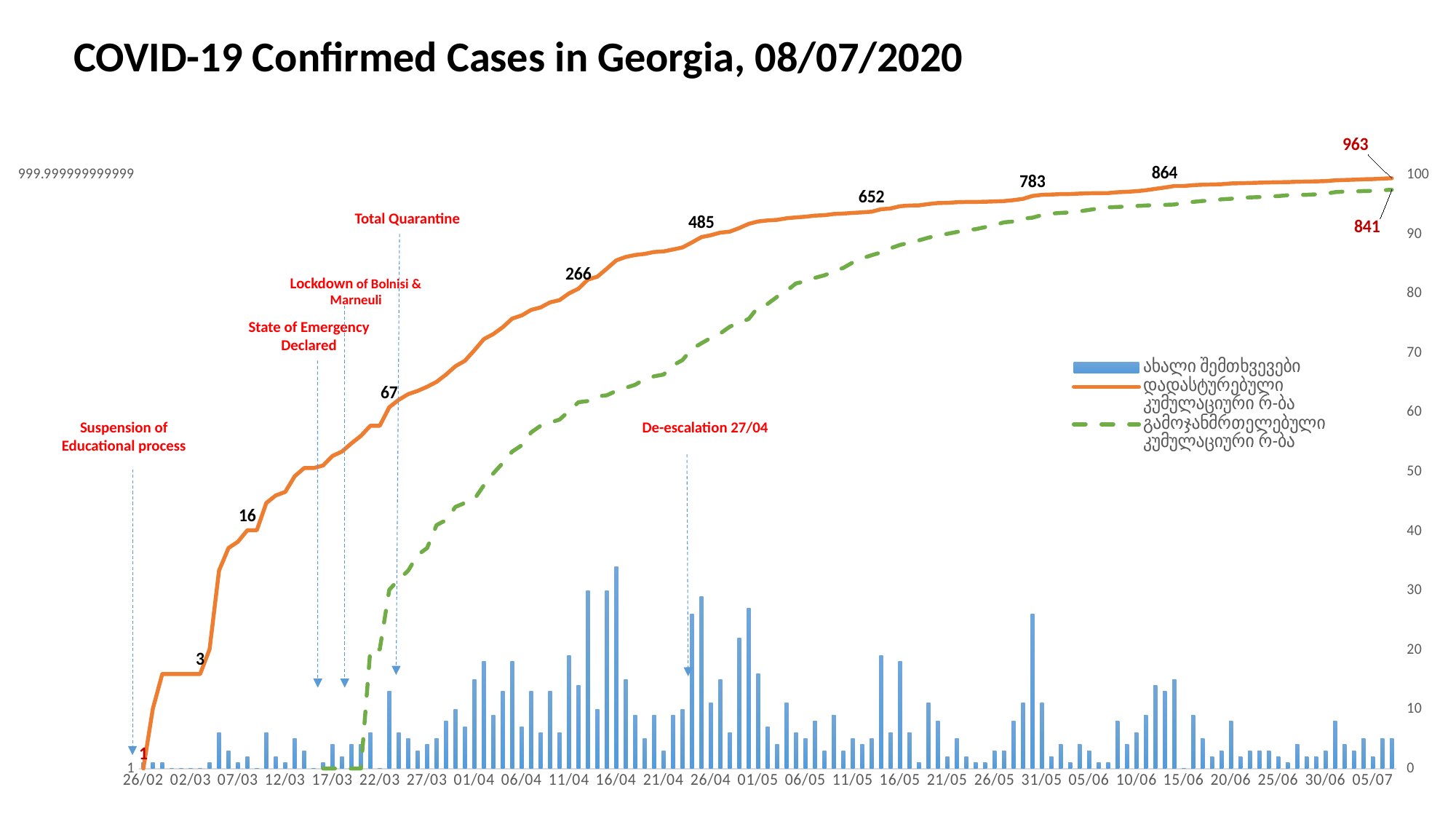
How many series does the legend list? 3 What is the last data label shown on the solid orange line? 963 Which line ends higher on the right side of the chart, the solid orange line or the green dashed line? The solid orange line What is the difference between the final labels of the orange line (963) and the green dashed line (841)? 122 What is the title of the chart? COVID-19 Confirmed Cases in Georgia, 08/07/2020 What event annotation is placed at the top of the chart above the 22/03 area? Total Quarantine What is the first data label shown on the solid orange line, at 26/02? 1 Is the tallest blue bar greater or less than 30 on the right-hand axis? greater Does the solid orange line rise or fall from left to right? Rise What kind of chart is this? Combined bar and line chart What is the data label shown at the end of the green dashed line? 841 What is the difference between the orange line labels 864 and 783? 81